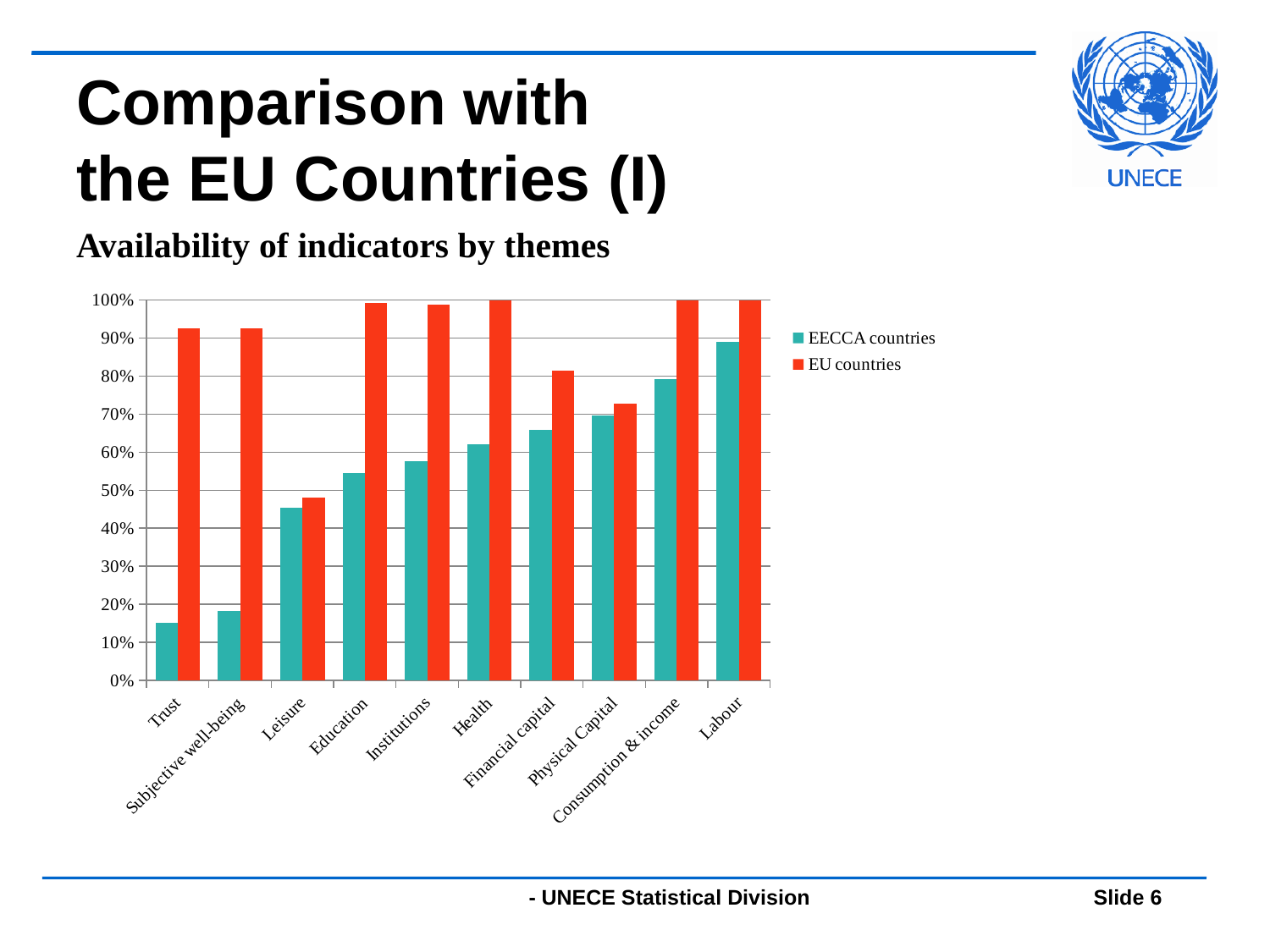
For Trust, which series has the larger value, EECCA countries or EU countries? EU countries Is the value for EECCA countries for Trust greater or less than 20%? less What is the value for EU countries for Health? 100% Is the value for EU countries for Leisure greater or less than 60%? less Which theme has the highest value for EECCA countries? Labour Do the EECCA countries values rise or fall from Trust to Labour along the x axis? Rise How many themes (categories) are shown on the x axis? 10 Is the value for EECCA countries for Labour greater or less than 80%? greater Which theme has the lowest value for EECCA countries? Trust What kind of chart is shown on the slide? Bar chart What is the value for EU countries for Labour? 100% How many series does the legend list? 2